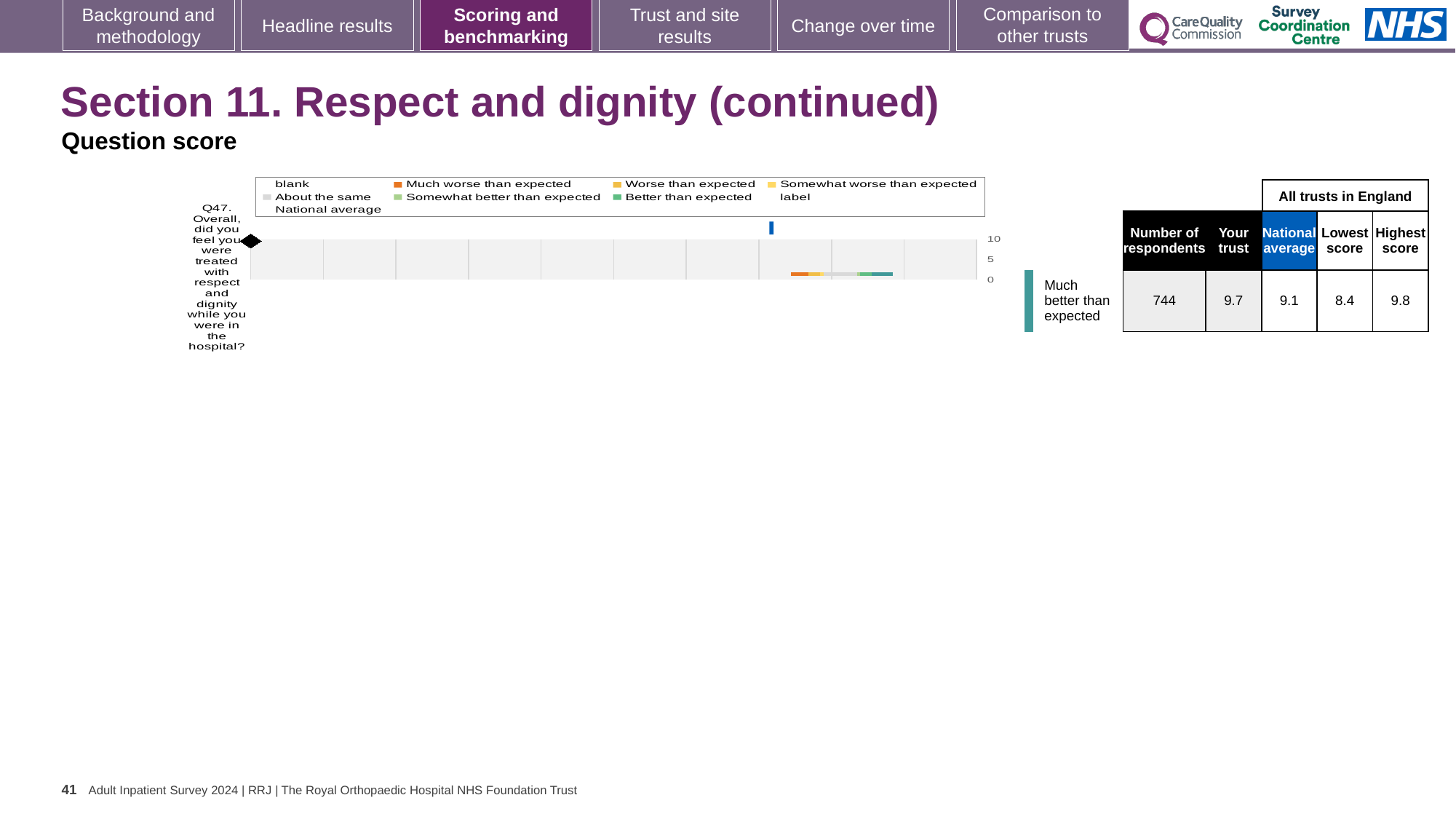
Which is larger for Q47, the 'Your trust' score or the national average? Your trust What is the highest score among all trusts in England for Q47? 9.8 What is the difference between the highest and lowest scores among all trusts in England for Q47? 1.4 What kind of chart is shown on the slide? bar chart What is the difference between the 'Your trust' score and the national average for Q47? 0.6 What is the 'Your trust' score for Q47 shown in the table next to the chart? 9.7 How many respondents answered Q47? 744 What benchmark category is the trust's result for Q47 labelled as next to the chart? Much better than expected What is the lowest score among all trusts in England for Q47? 8.4 How many survey questions are plotted on the chart? 1 What is the national average score for Q47 shown in the table next to the chart? 9.1 Is the 'Your trust' score for Q47 greater or less than 5 on the chart's axis? greater